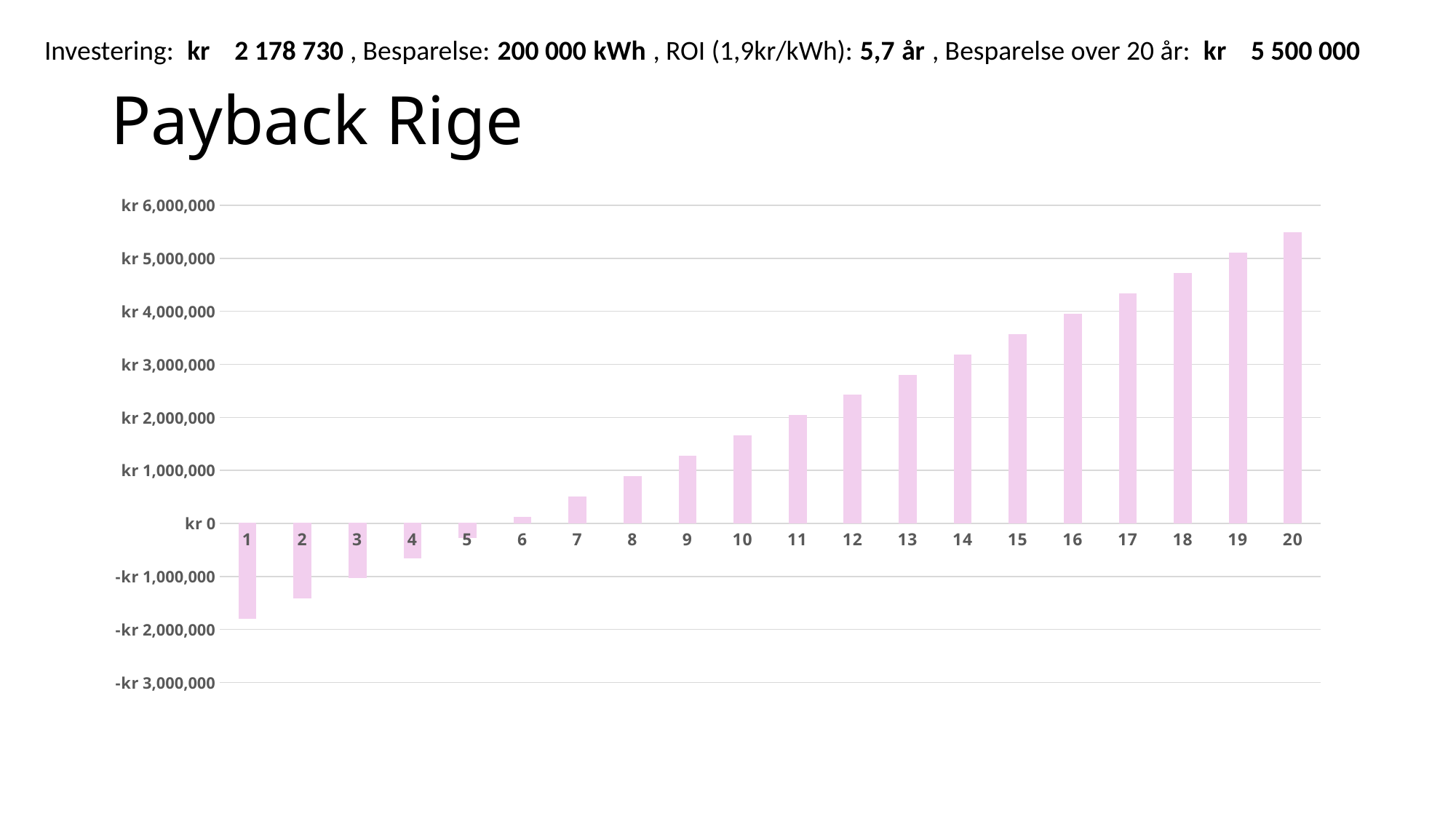
What kind of chart is shown on the slide? bar chart What is the title of the chart? Payback Rige Is the value for year 1 greater or less than -kr 1,000,000? less Is the value for year 15 greater or less than kr 4,000,000? less Do the values rise or fall as the years increase along the x axis? rise Which year has the highest value? 20 Which has the larger value, year 8 or year 12? 12 How many years have a negative value (bars below kr 0)? 5 Is the value for year 20 greater or less than kr 5,000,000? greater How many categories (years) are plotted on the x axis? 20 Which year has the lowest value? 1